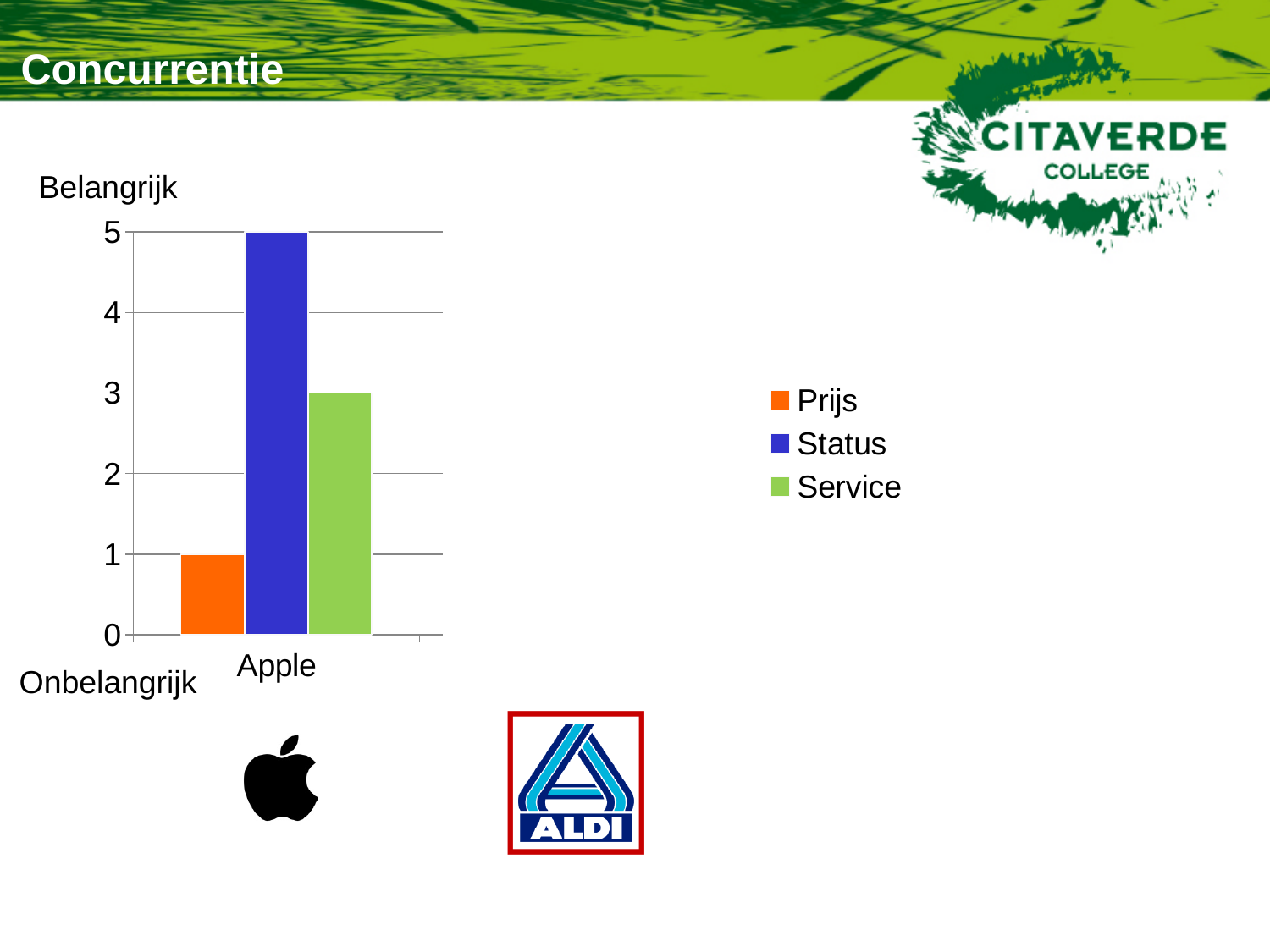
What colour is the Status series in the chart? blue What is the value for Service for Apple? 3 What is the value for Status for Apple? 5 What is the value for Prijs for Apple? 1 How many series does the legend list? 3 What kind of chart is shown on the slide? bar chart Which is larger for Apple, Service or Prijs? Service How many categories are shown on the x axis of the chart? 1 Is the value for Service for Apple greater or less than 2? greater Which series has the lowest value for Apple? Prijs Which series has the highest value for Apple? Status What is the difference between the Status and Prijs values for Apple? 4